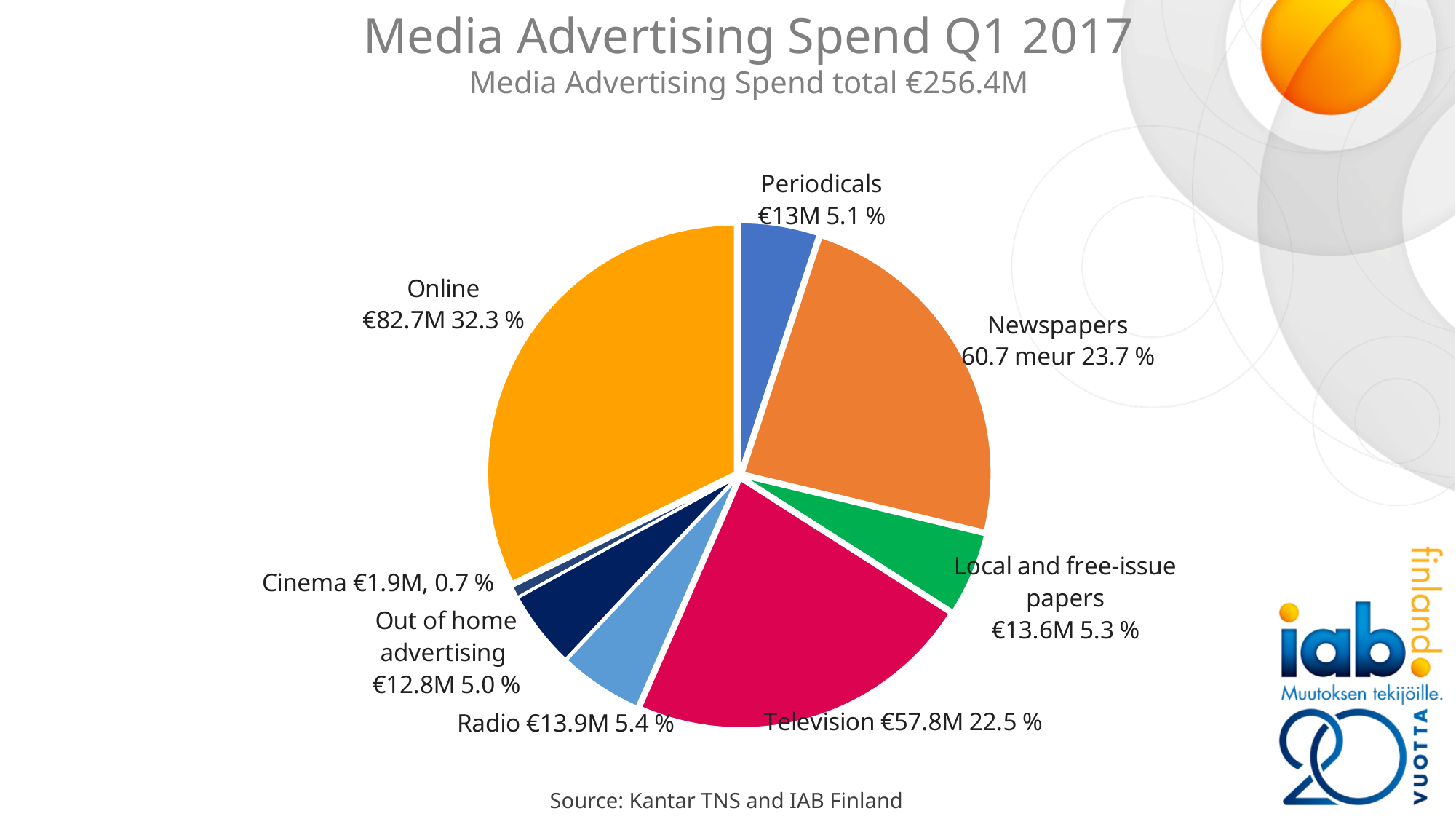
What is the difference in spend between Radio and Out of home advertising? €1.1M How many categories are shown in the pie chart? 8 What is the difference in percentage share between Online and Newspapers? 8.6 % What share of the pie does Television account for? 22.5 % What type of chart is shown on the slide? Pie chart Which category has the largest share of media advertising spend? Online Which has a larger advertising spend, Newspapers or Television? Newspapers What is the percentage share for Out of home advertising? 5.0 % What is the advertising spend for Radio? €13.9M What is the total media advertising spend stated in the chart subtitle? €256.4M Which category has the smallest share of media advertising spend? Cinema What is the media advertising spend for Online? €82.7M